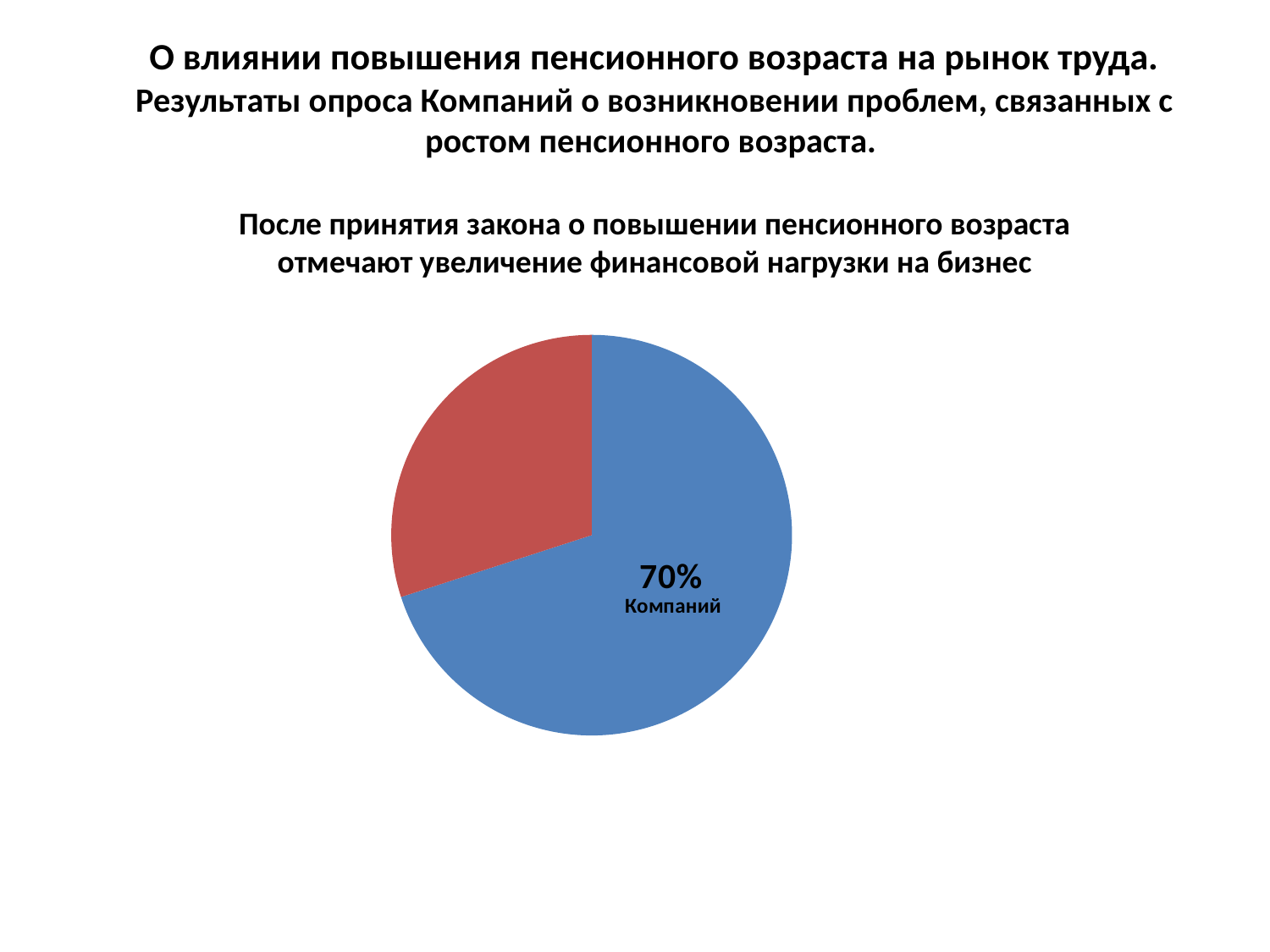
What kind of chart is shown on the slide? pie chart How many slices does the pie chart have? 2 What percentage is printed on the blue slice of the pie chart? 70% What colour is the slice labelled 70%? blue What share of the pie does the slice labelled "Компаний" represent? 70% Which slice of the pie chart is larger, the blue one or the red one? the blue one Which slice of the pie chart is the largest? the blue slice (70% Компаний) What is the title of the pie chart? После принятия закона о повышении пенсионного возраста отмечают увеличение финансовой нагрузки на бизнес Which slice of the pie chart is the smallest? the red slice